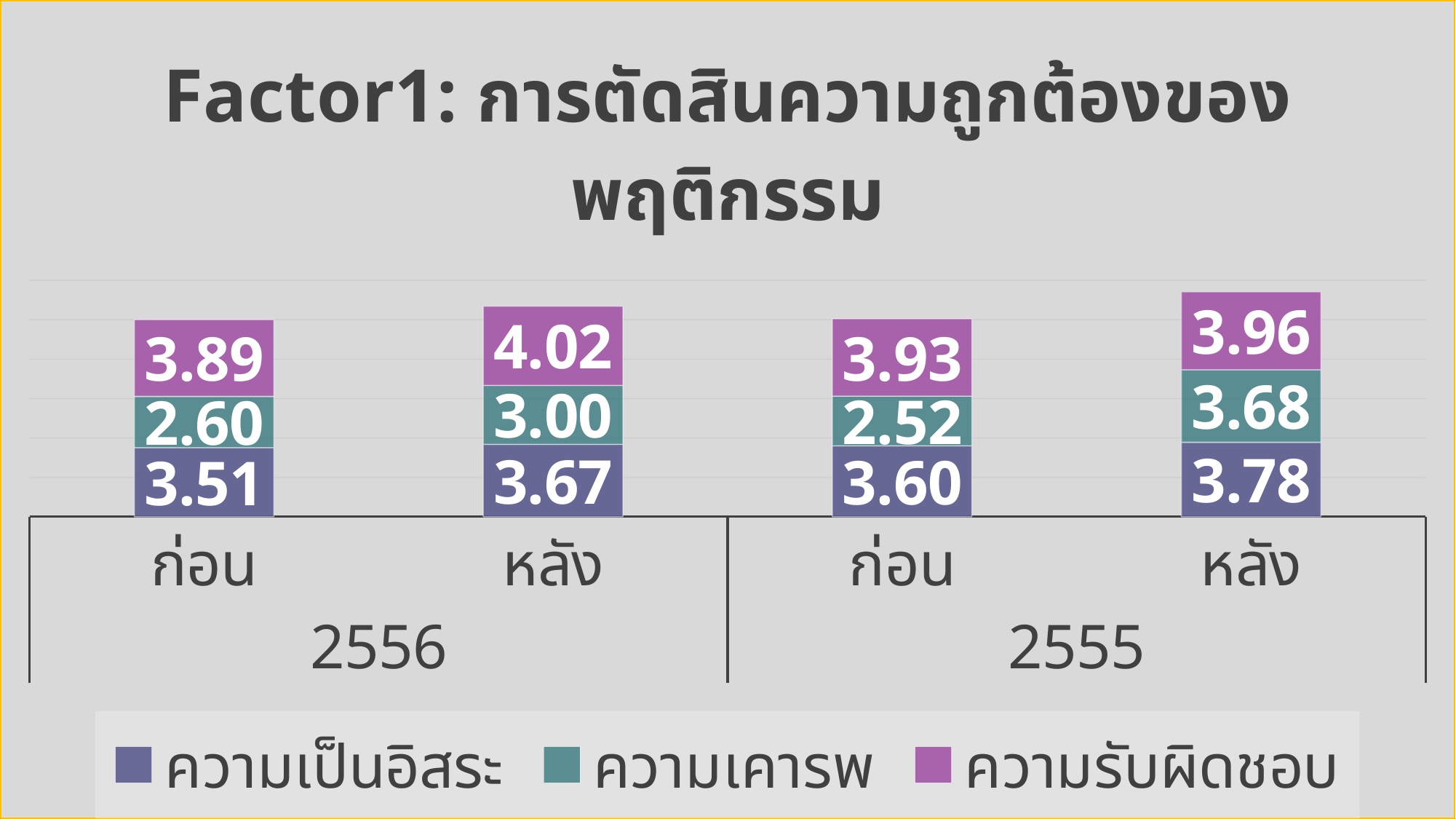
What is the value of ความเคารพ for หลัง in 2556? 3.00 How many stacked bars are shown in the chart? 4 What is the difference between the ความเคารพ values for หลัง 2555 and ก่อน 2555? 1.16 What is the total of the stacked bar for หลัง 2555? 11.42 Which category has the highest value for ความรับผิดชอบ? หลัง 2556 How many series does the legend list? 3 Which category has the lowest value for ความเคารพ? ก่อน 2555 What is the total of the stacked bar for ก่อน 2556? 10.00 What kind of chart is shown on the slide? Stacked bar chart What is the value of ความเป็นอิสระ for ก่อน in 2555? 3.60 What is the value of ความรับผิดชอบ for หลัง in 2555? 3.96 Which is larger: ความเป็นอิสระ for หลัง 2556 or ความเป็นอิสระ for หลัง 2555? หลัง 2555